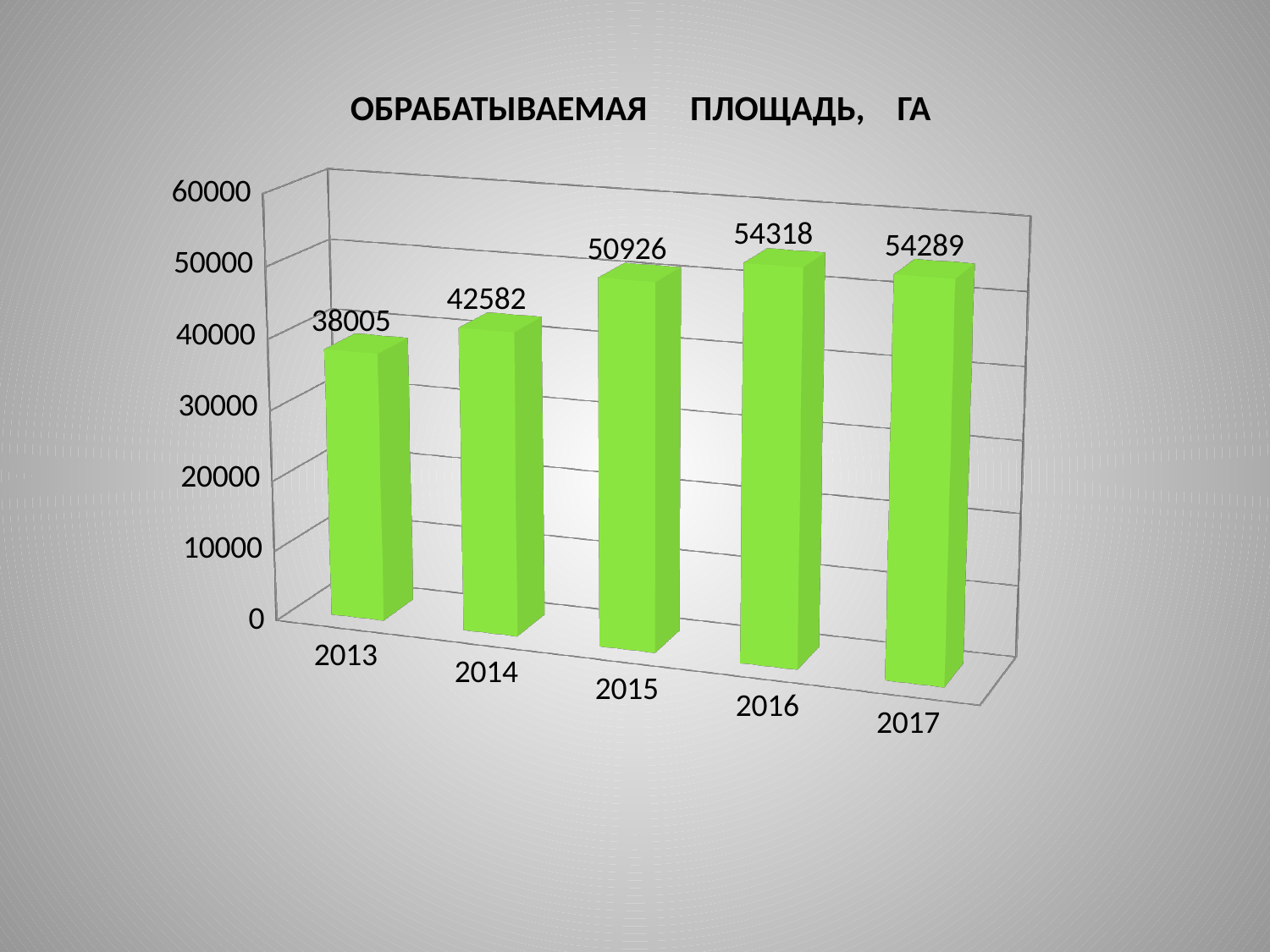
Which year has the highest value? 2016 What is the value for 2017? 54289 What is the difference between the values for 2016 and 2017? 29 Which year has the lowest value? 2013 Do the values rise or fall from 2013 to 2016? rise How many years are shown on the x axis? 5 What is the difference between the values for 2014 and 2013? 4577 What is the value for 2015? 50926 Which is larger, the value for 2015 or the value for 2014? 2015 What is the value for 2013? 38005 Is the value for 2013 greater or less than 40000? less What kind of chart is this? bar chart